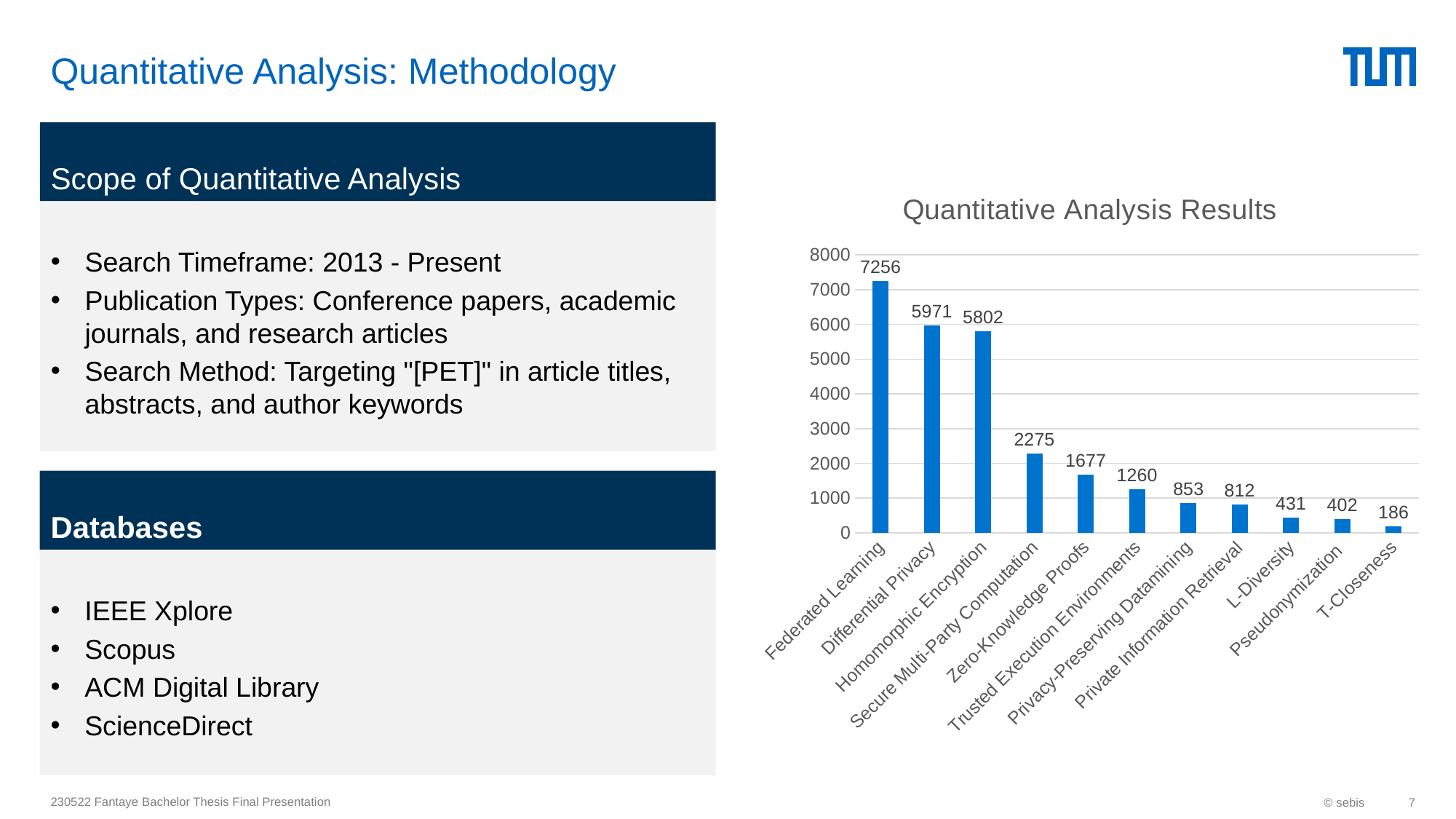
Which is larger, the value for Privacy-Preserving Datamining or the value for Private Information Retrieval? Privacy-Preserving Datamining What is the difference between the values for Zero-Knowledge Proofs and Trusted Execution Environments? 417 What is the title of the chart? Quantitative Analysis Results Do the values rise or fall from left to right along the x axis? Fall How many categories are shown in the chart? 11 Which category has the highest value? Federated Learning What is the value for Pseudonymization? 402 What is the value for Secure Multi-Party Computation? 2275 What is the value for Federated Learning? 7256 What is the difference between the values for Differential Privacy and Homomorphic Encryption? 169 Which category has the lowest value? T-Closeness What kind of chart is shown on the slide? Bar chart